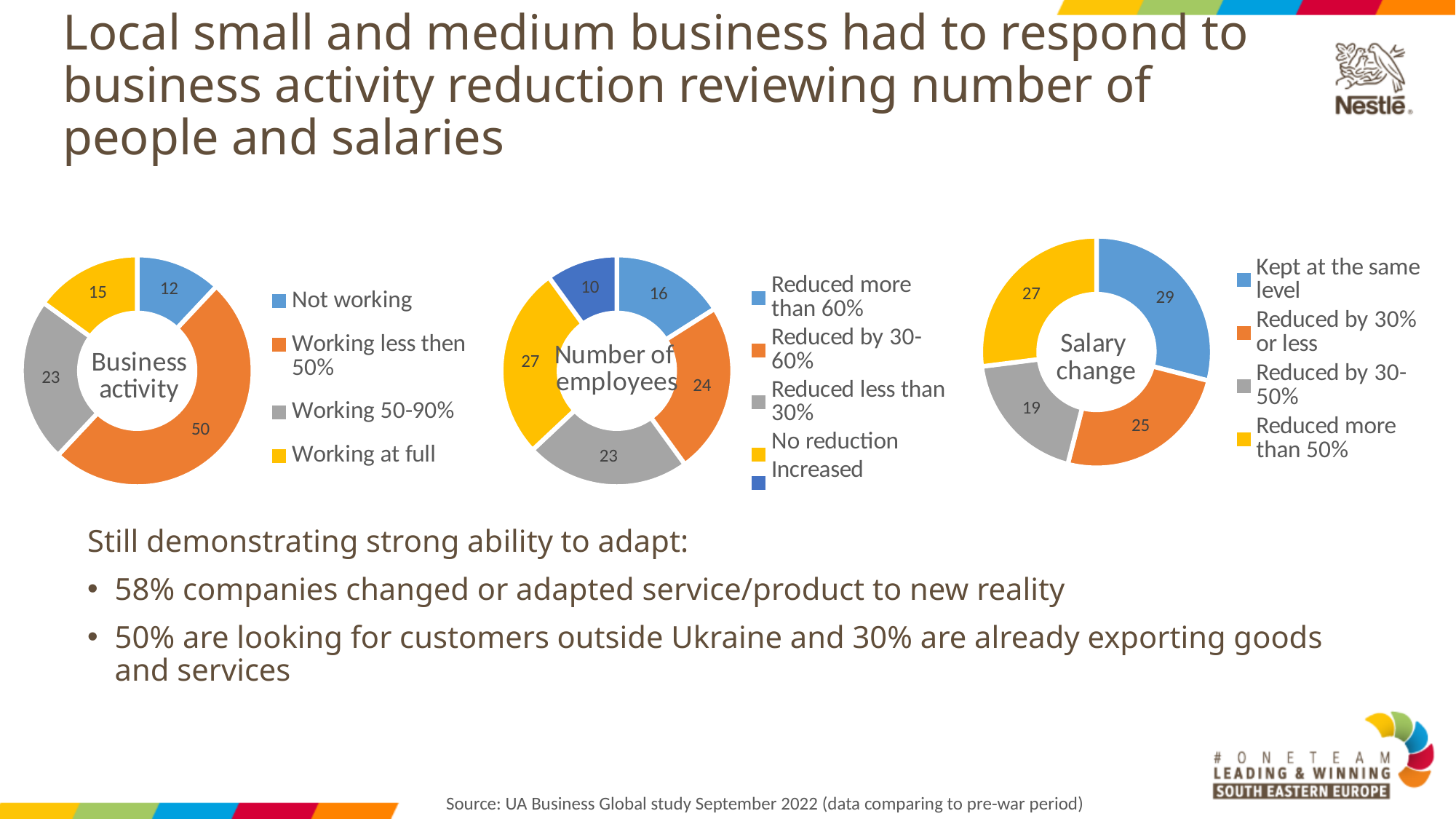
In the 'Number of employees' chart, what is the value for 'No reduction'? 27 In the 'Salary change' chart, what is the difference between 'Reduced more than 50%' and 'Reduced by 30-50%'? 8 In the 'Number of employees' chart, which is larger: 'Reduced by 30-60%' or 'Reduced more than 60%'? Reduced by 30-60% How many categories does the 'Business activity' chart show? 4 How many categories does the 'Number of employees' chart show? 5 In the 'Business activity' chart, what is the value for 'Working less then 50%'? 50 In the 'Salary change' chart, which category has the highest value? Kept at the same level In the 'Business activity' chart, what is the difference between 'Working 50-90%' and 'Working at full'? 8 In the 'Number of employees' chart, which category has the lowest value? Increased What type of chart is the 'Salary change' chart? Doughnut chart In the 'Salary change' chart, what is the value for 'Kept at the same level'? 29 In the 'Business activity' chart, which category has the smallest value? Not working